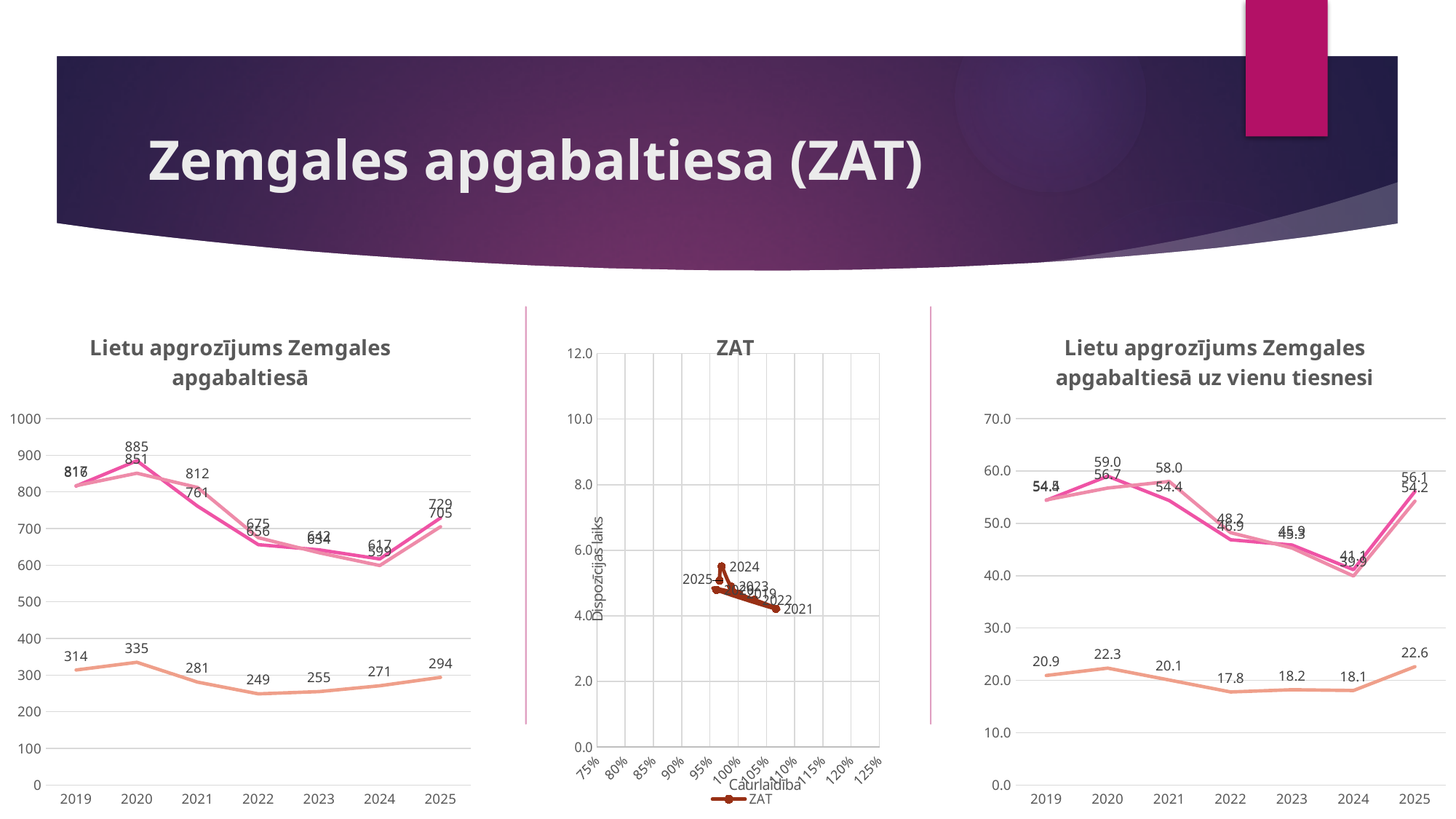
In the chart 'Lietu apgrozījums Zemgales apgabaltiesā', how many years are shown on the x axis? 7 In the chart 'Lietu apgrozījums Zemgales apgabaltiesā uz vienu tiesnesi', does the lowest line rise or fall from 2024 to 2025? rise In the chart 'Lietu apgrozījums Zemgales apgabaltiesā', in which year does the lowest line reach its lowest value? 2022 In the chart 'Lietu apgrozījums Zemgales apgabaltiesā uz vienu tiesnesi', in which year does the lowest line reach its lowest value? 2022 In the chart 'Lietu apgrozījums Zemgales apgabaltiesā', what is the value of the lowest line in 2022? 249 What kind of chart is 'Lietu apgrozījums Zemgales apgabaltiesā'? Line chart In the chart 'Lietu apgrozījums Zemgales apgabaltiesā uz vienu tiesnesi', is the lowest line's value in 2020 larger or smaller than its value in 2021? larger In the chart 'Lietu apgrozījums Zemgales apgabaltiesā uz vienu tiesnesi', what is the value of the lowest line in 2025? 22.6 In the middle chart titled 'ZAT', what is the label of the x axis? Caurlaidība In the chart 'Lietu apgrozījums Zemgales apgabaltiesā', what is the difference between the lowest line's values in 2020 and 2022? 86 In the chart 'Lietu apgrozījums Zemgales apgabaltiesā', what is the value of the lowest line in 2020? 335 In the chart 'Lietu apgrozījums Zemgales apgabaltiesā', in which year does the lowest line reach its highest value? 2020